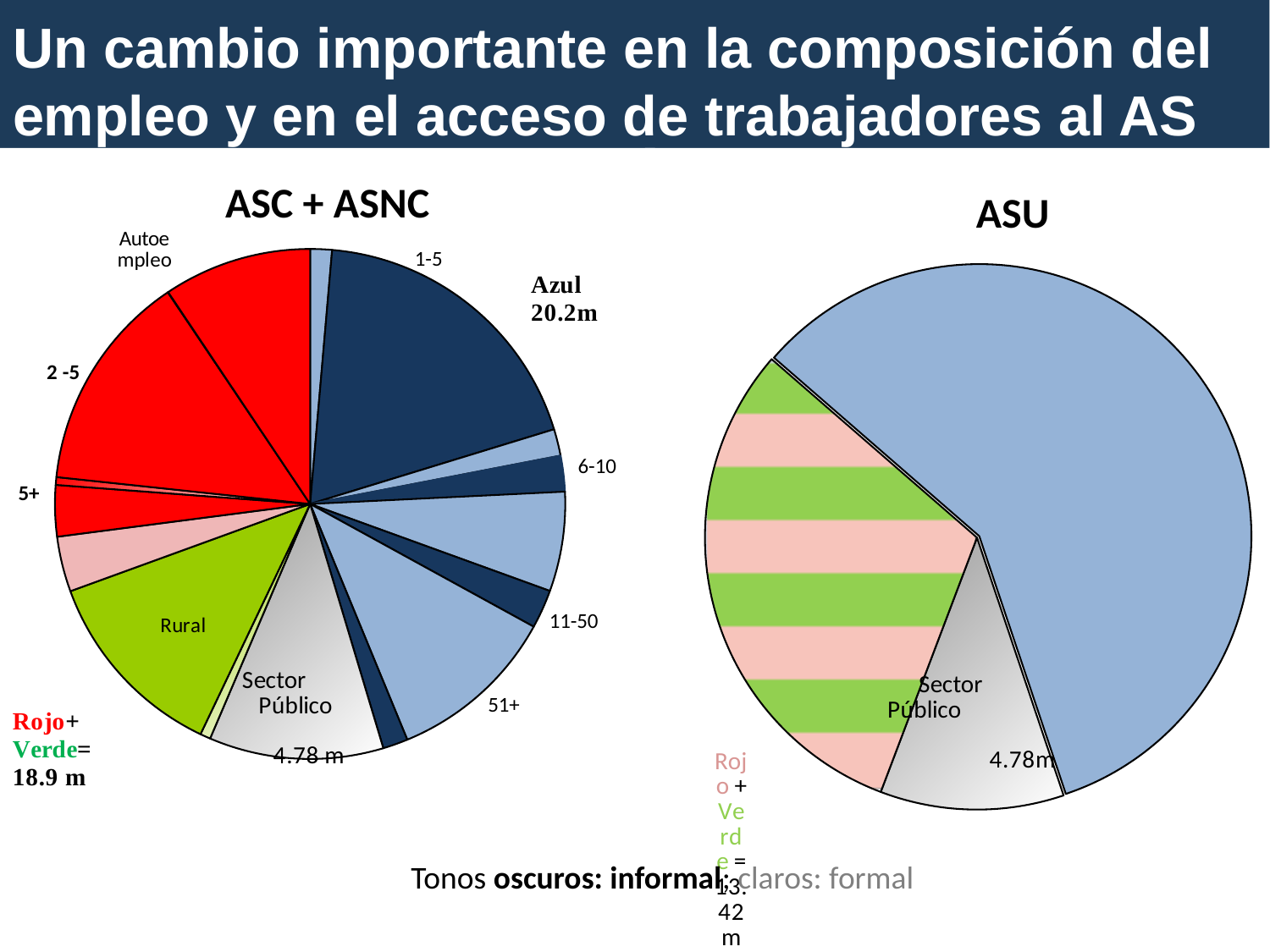
What kind of chart is the ASU chart on the right? Pie chart In the ASC + ASNC chart, which is larger, the Azul total or the Rojo + Verde total? Azul What is the title of the pie chart on the left? ASC + ASNC What kind of chart is the ASC + ASNC chart on the left? Pie chart In the ASU chart, what total is given for Rojo + Verde? 13.42 m In the ASC + ASNC chart, what total is given for the Azul (blue) slices? 20.2m In the ASU chart, what value is shown for Sector Público? 4.78m What is the difference between the Rojo + Verde total in the ASC + ASNC chart and the Rojo + Verde total in the ASU chart? 5.48 m In the ASU chart, is the Sector Público slice larger or smaller than the striped red-and-green slice? Smaller In the ASC + ASNC chart, what total is given for Rojo + Verde? 18.9 m In the ASC + ASNC chart, what value is shown for Sector Público? 4.78 m Which chart shows the larger Rojo + Verde total, ASC + ASNC or ASU? ASC + ASNC